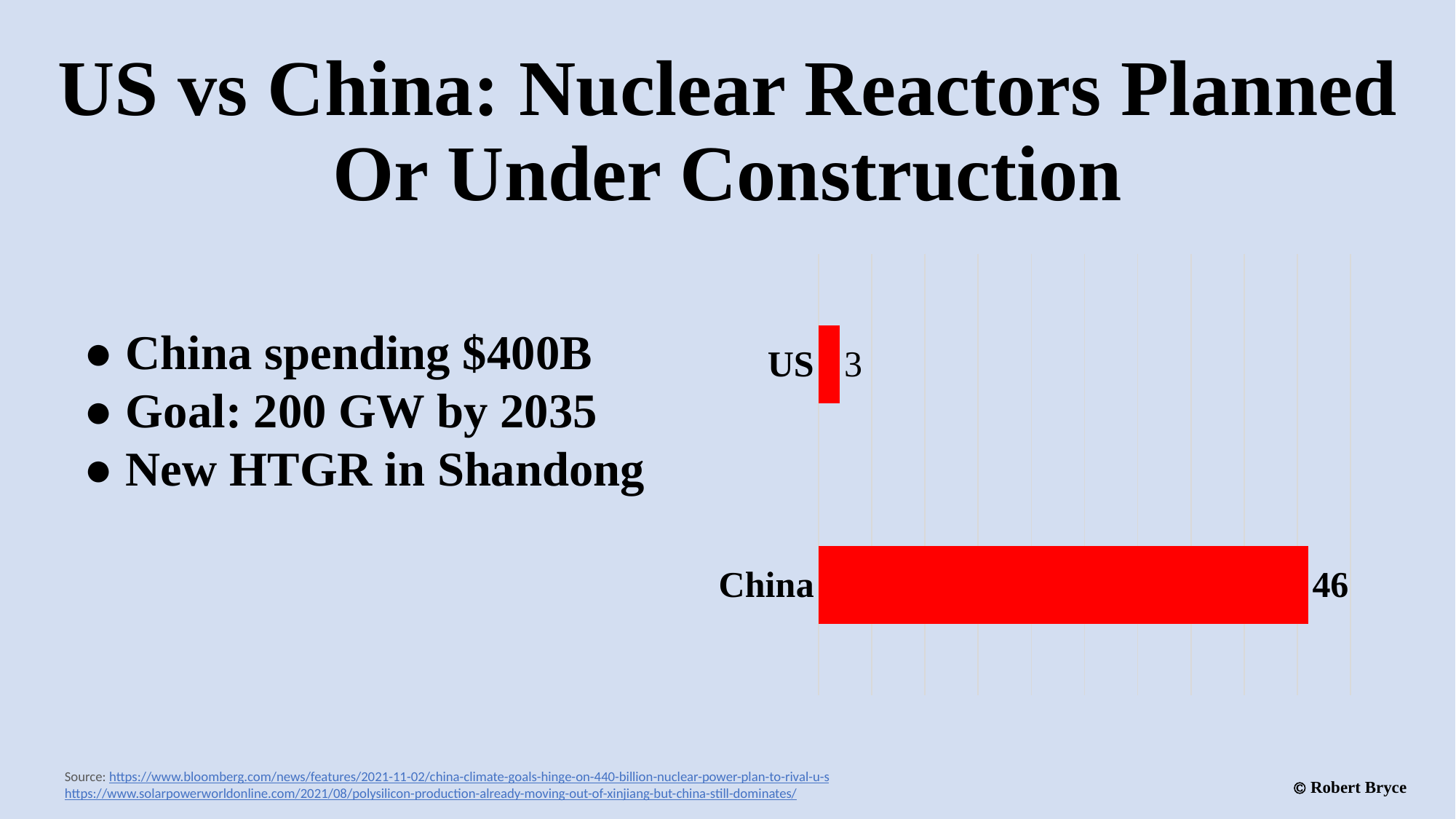
How many categories are shown in the chart? 2 What is the difference between the values for China and US? 43 Which category has the lowest value in the chart? US Which category has the highest value in the chart? China Which has a larger value, US or China? China What colour are the bars in the chart? Red What is the value for US in the chart? 3 What is the value for China in the chart? 46 What kind of chart is shown on the slide? Bar chart Are the bars in the chart horizontal or vertical? Horizontal